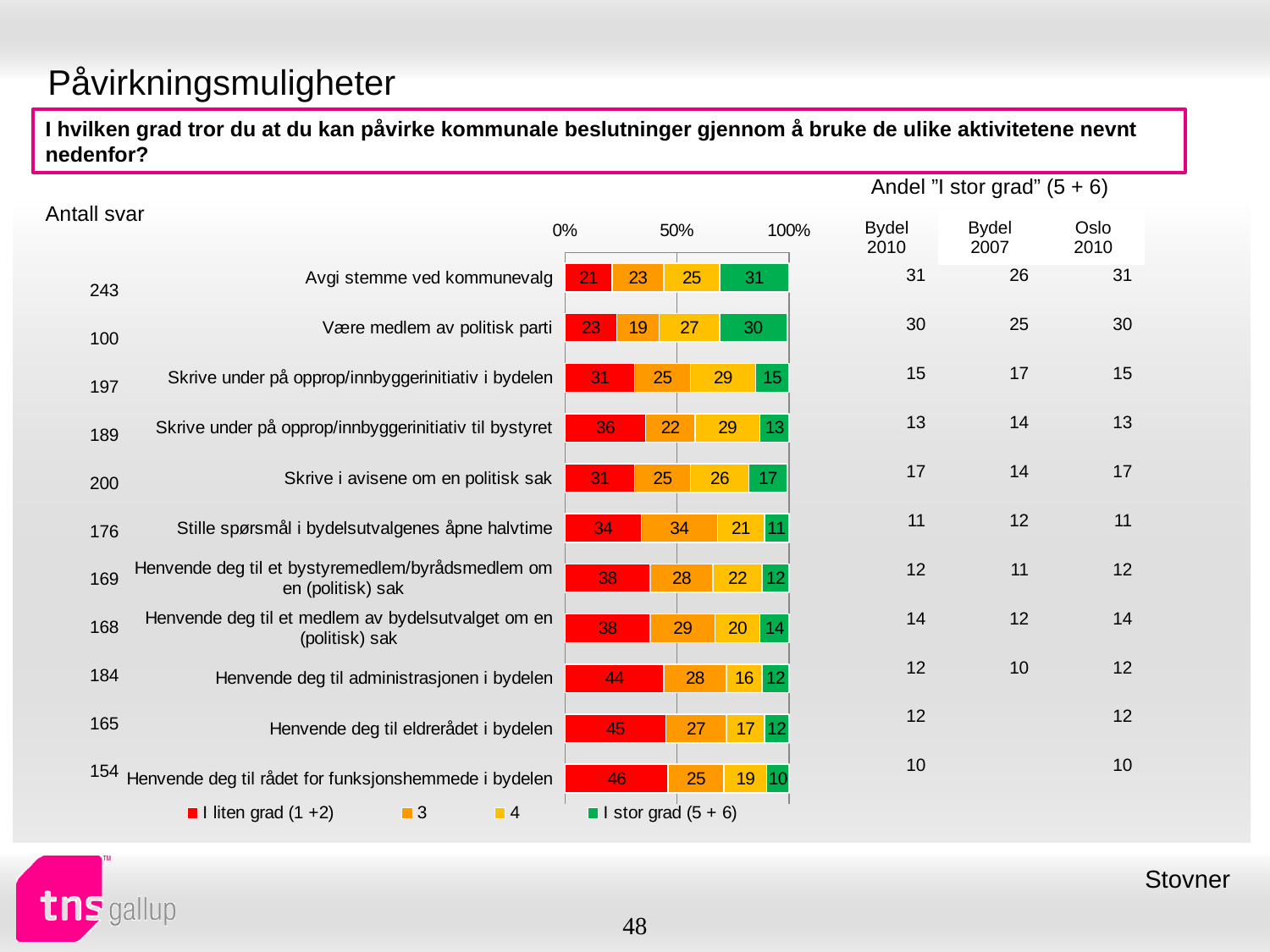
Which series is shown in green in the chart? I stor grad (5 + 6) What is the value of "I liten grad (1 +2)" for "Avgi stemme ved kommunevalg"? 21 What kind of chart is shown on the slide? Stacked bar chart How many series does the chart legend list? 4 Which category has the highest value for "I liten grad (1 +2)"? Henvende deg til rådet for funksjonshemmede i bydelen Which has a larger "I stor grad (5 + 6)" value: "Skrive i avisene om en politisk sak" or "Skrive under på opprop/innbyggerinitiativ til bystyret"? Skrive i avisene om en politisk sak What is the value of "I stor grad (5 + 6)" for "Være medlem av politisk parti"? 30 What is the difference between the "I liten grad (1 +2)" values for "Henvende deg til administrasjonen i bydelen" and "Avgi stemme ved kommunevalg"? 23 What is the total of the stacked bar for "Avgi stemme ved kommunevalg"? 100 How many categories are shown in the bar chart? 11 What is the value of series "3" for "Stille spørsmål i bydelsutvalgenes åpne halvtime"? 34 Which category has the lowest value for "I stor grad (5 + 6)"? Henvende deg til rådet for funksjonshemmede i bydelen